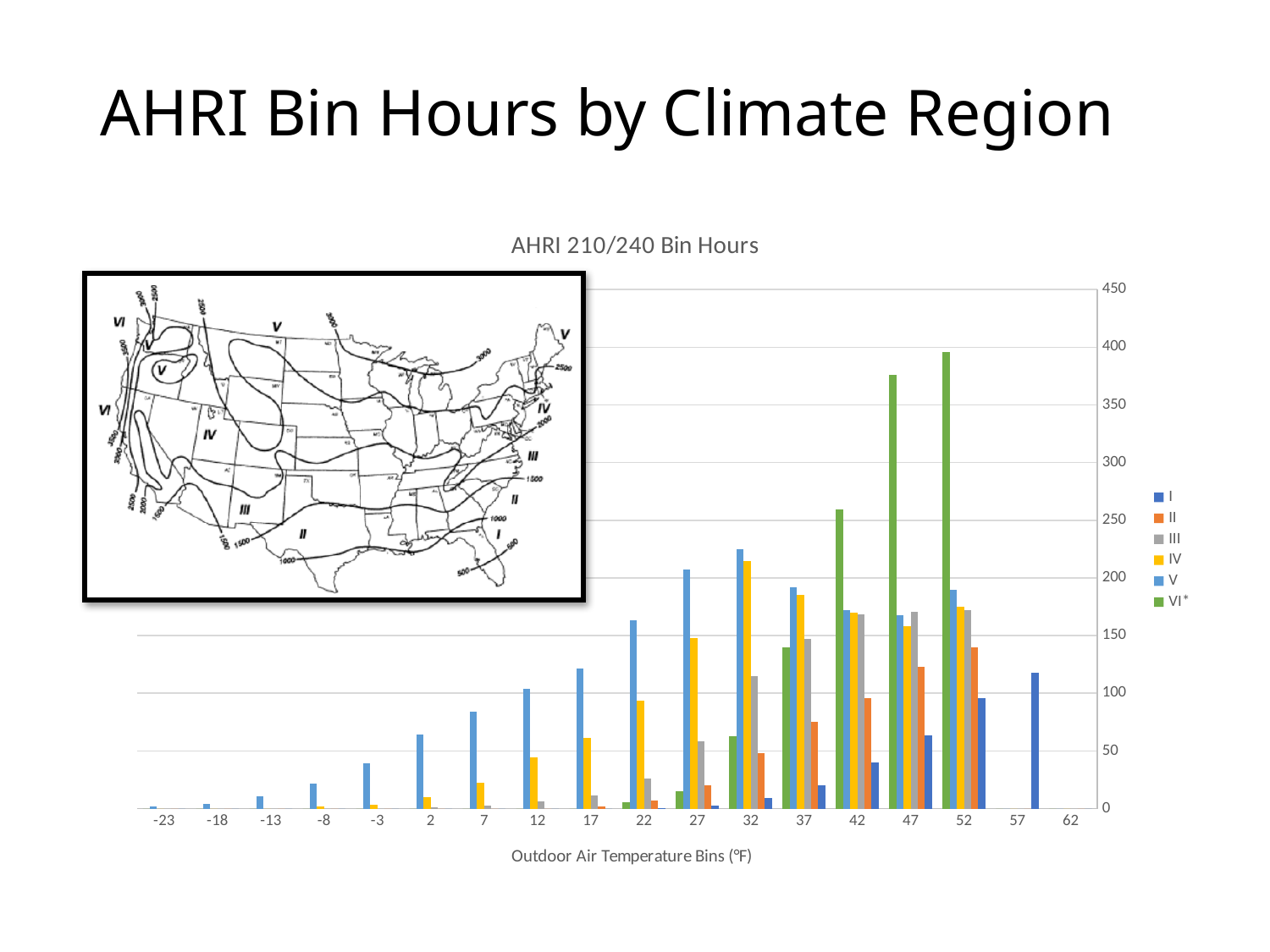
At which temperature bin does series VI* reach its highest value? 52 At the 47 bin, which series has the larger value, VI* or V? VI* How many temperature bins are shown along the x axis? 18 Is the value for series VI* at the 52 bin greater or less than 350? greater What is the x-axis title of the chart? Outdoor Air Temperature Bins (°F) Is the value for series I at the 57 bin greater or less than 100? greater Is the value for series V at the 32 bin greater or less than 200? greater Which series has the tallest bar in the chart? VI* How many series does the chart legend list? 6 What kind of chart is shown on the slide? bar chart What is the title of the chart? AHRI 210/240 Bin Hours